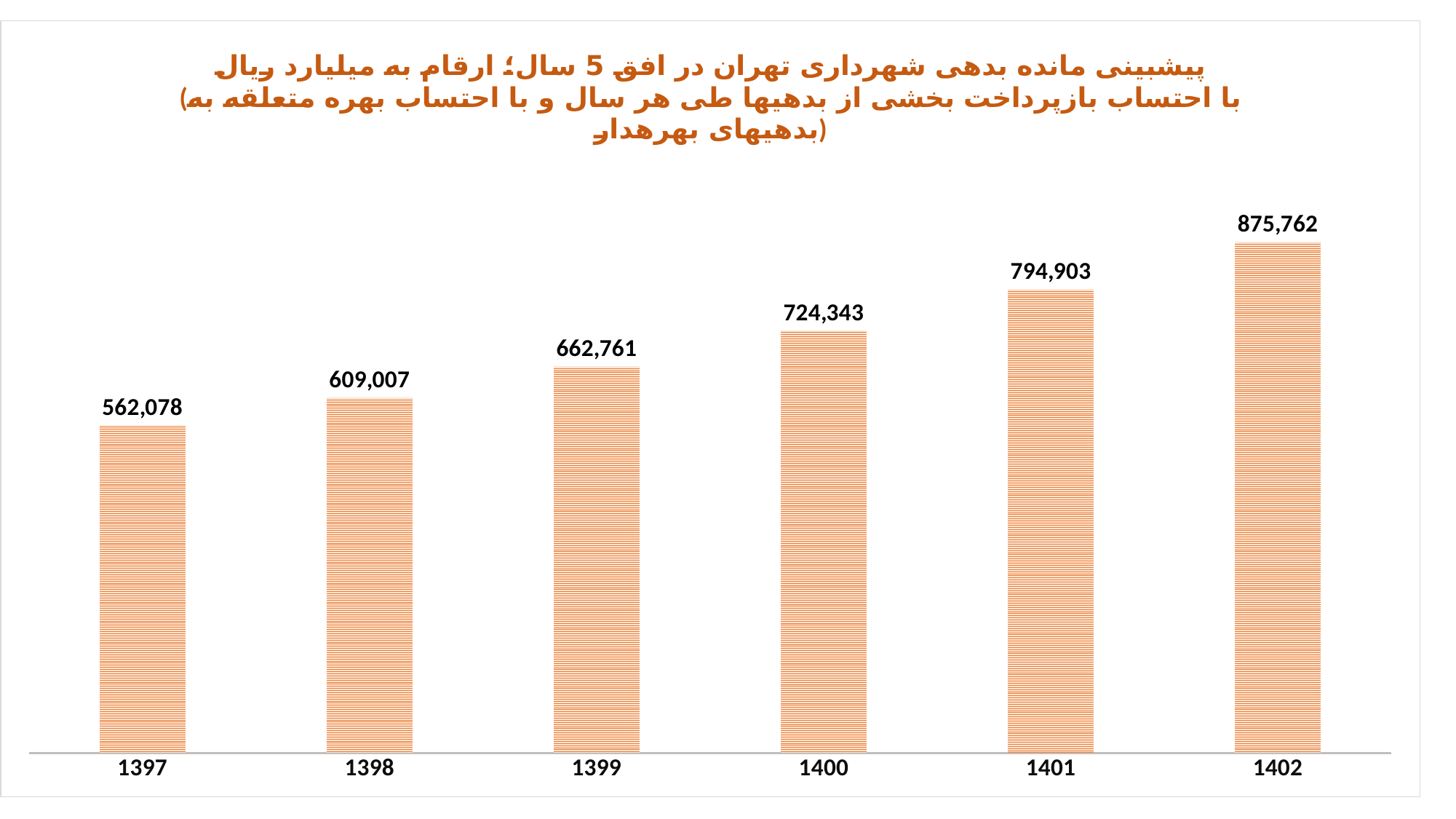
Which year has the highest value? 1402 What is the difference between the values for 1401 and 1400? 70,560 What is the difference between the values for 1402 and 1397? 313,684 What is the value shown for 1402? 875,762 What is the value shown for 1399? 662,761 Which year has the lowest value? 1397 Do the values rise or fall from 1397 to 1402? Rise What is the value shown for 1397? 562,078 How many years are shown on the x axis? 6 What is the value shown for 1400? 724,343 Which is larger, the value for 1398 or the value for 1401? 1401 What kind of chart is this? Bar chart